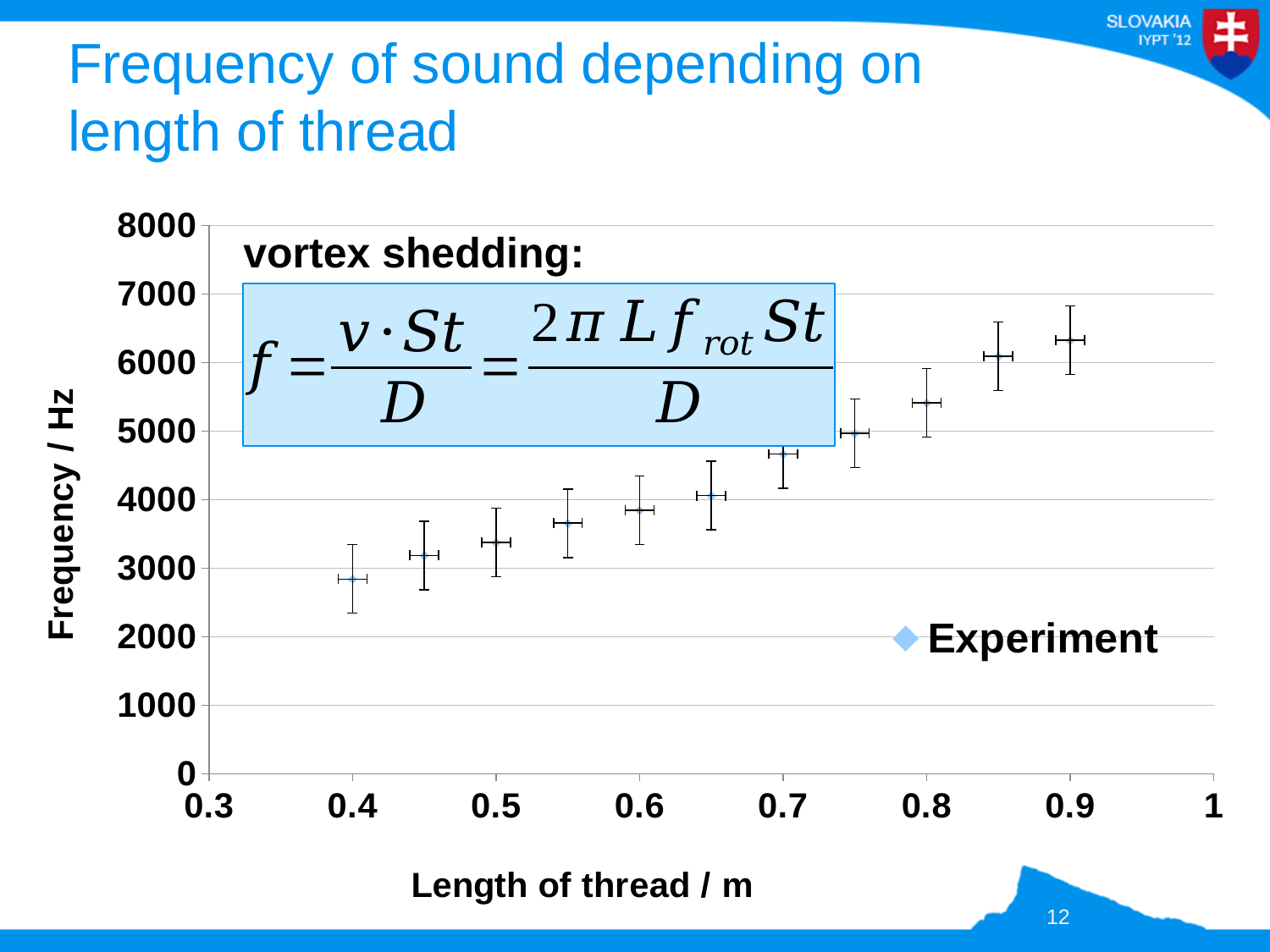
How many data points are plotted in the chart? 11 What is the name of the series shown in the legend? Experiment Does the frequency rise or fall as the length of thread increases? Rise At which length of thread is the frequency highest? 0.9 How many series does the legend list? 1 Is the frequency at a thread length of 0.7 m greater or less than 4000? greater Is the frequency at a thread length of 0.9 m greater or less than 6000? greater At which length of thread is the frequency lowest? 0.4 What is the title of the vertical axis? Frequency / Hz Is the frequency at a thread length of 0.75 m greater or less than 6000? less What kind of chart is shown on the slide? Scatter chart Which has the higher frequency: the point at 0.4 m or the point at 0.9 m? 0.9 m